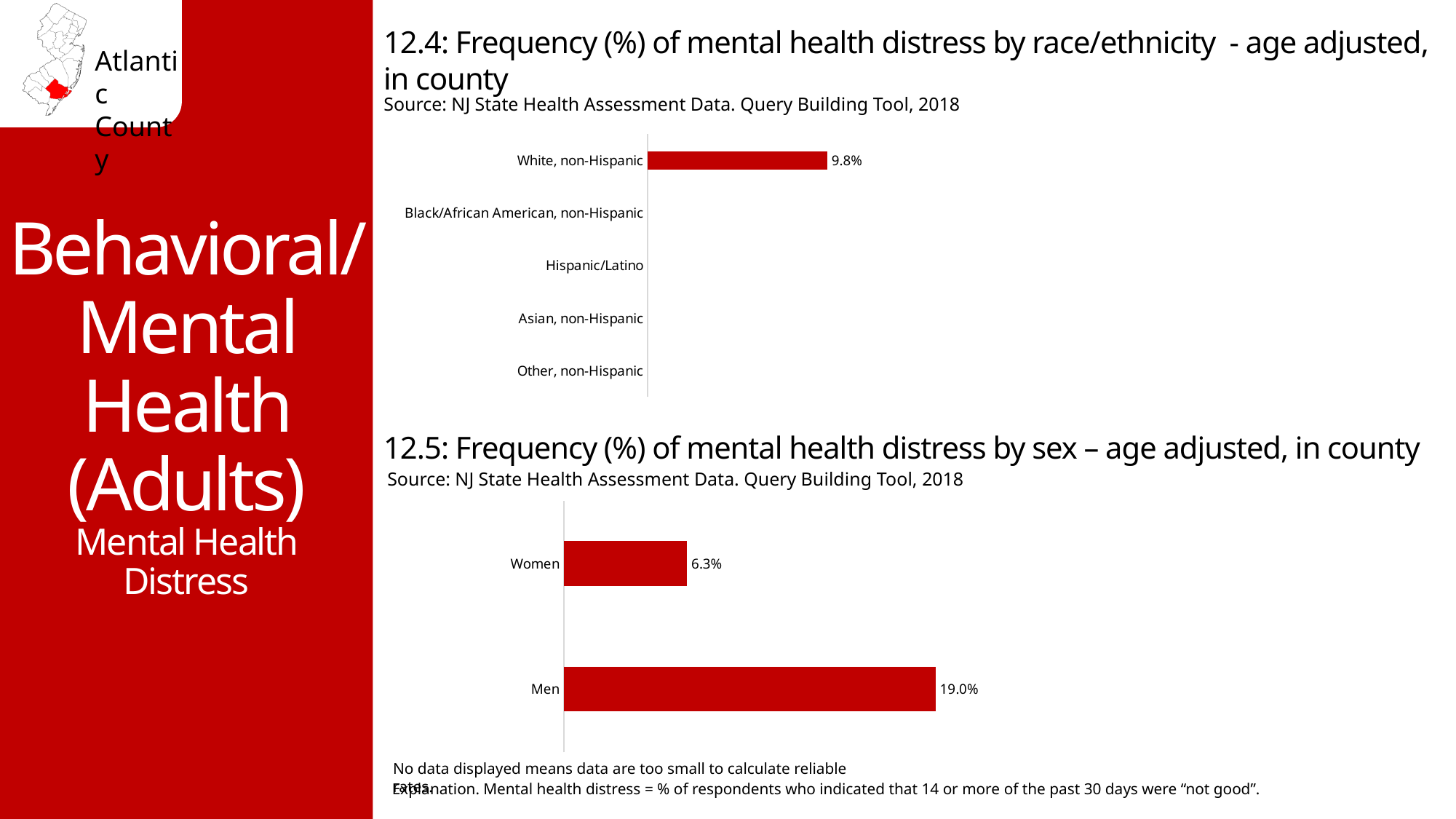
In the chart '12.4: Frequency (%) of mental health distress by race/ethnicity', how many race/ethnicity categories are listed on the axis? 5 In the chart '12.4: Frequency (%) of mental health distress by race/ethnicity', which category is the only one with a bar displayed? White, non-Hispanic In the chart '12.5: Frequency (%) of mental health distress by sex', what is the value for Men? 19.0% In the chart '12.5: Frequency (%) of mental health distress by sex', is the value for Men or Women larger? Men In the chart '12.5: Frequency (%) of mental health distress by sex', what is the value for Women? 6.3% In the chart '12.5: Frequency (%) of mental health distress by sex', what is the difference between the values for Men and Women? 12.7% In the chart '12.4: Frequency (%) of mental health distress by race/ethnicity', what is the value for White, non-Hispanic? 9.8% In the chart '12.5: Frequency (%) of mental health distress by sex', which category has the highest value? Men What kind of chart is '12.5: Frequency (%) of mental health distress by sex'? Bar chart What kind of chart is '12.4: Frequency (%) of mental health distress by race/ethnicity'? Bar chart In the chart '12.5: Frequency (%) of mental health distress by sex', which category has the lowest value? Women In the chart '12.5: Frequency (%) of mental health distress by sex', how many categories are shown? 2